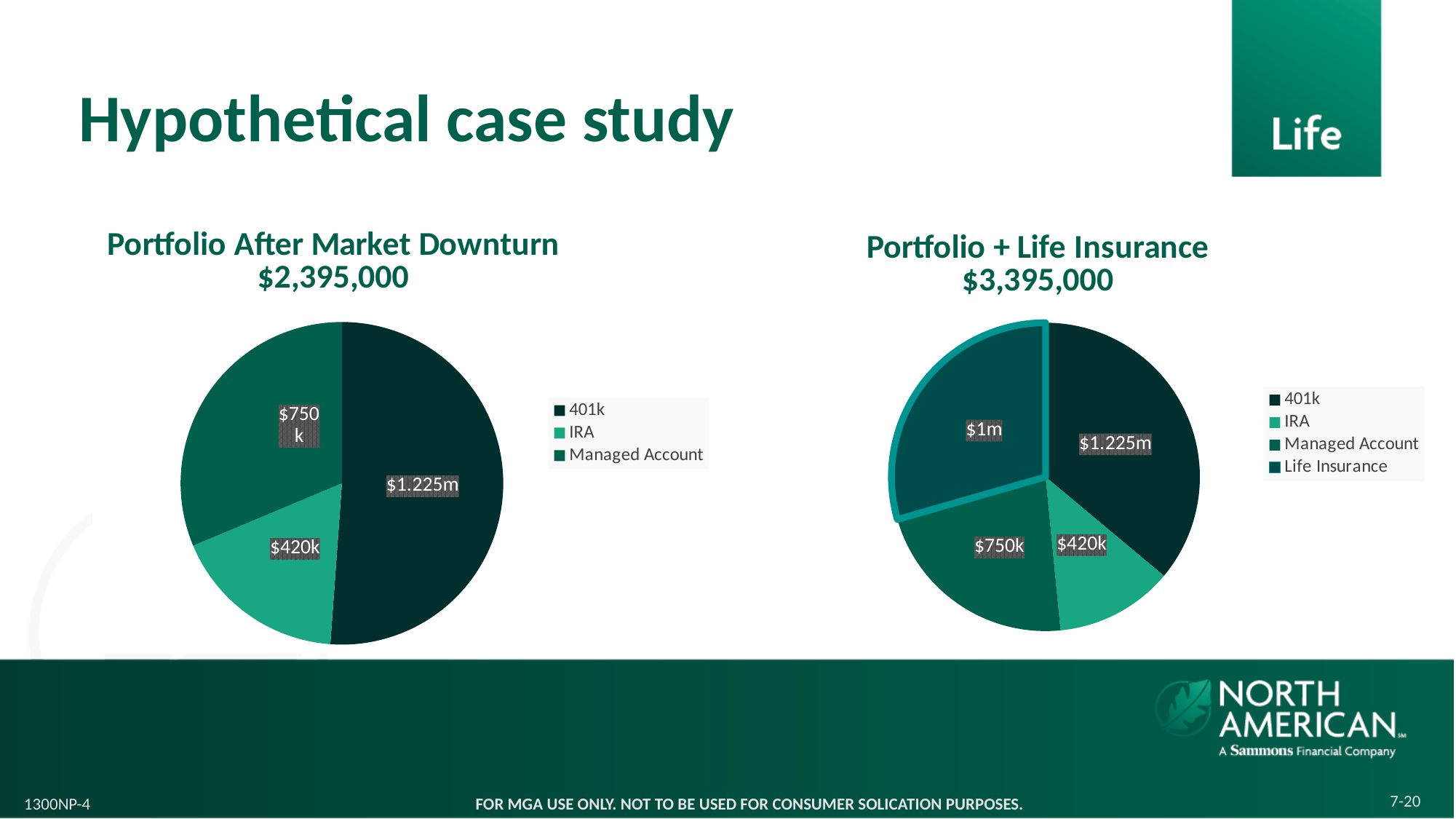
How many entries does the legend of the Portfolio After Market Downturn chart list? 3 In the Portfolio After Market Downturn chart, which category has the largest slice? 401k What total value is shown under the title of the Portfolio + Life Insurance chart? $3,395,000 What kind of chart is the Portfolio After Market Downturn chart? Pie chart In the Portfolio + Life Insurance chart, which is larger, the Life Insurance slice or the Managed Account slice? Life Insurance In the Portfolio After Market Downturn chart, what is the value of the 401k slice? $1.225m In the Portfolio After Market Downturn chart, what is the value of the IRA slice? $420k How many slices does the Portfolio + Life Insurance chart have? 4 In the Portfolio + Life Insurance chart, what is the value of the Managed Account slice? $750k In the Portfolio After Market Downturn chart, what is the difference between the 401k value and the IRA value? $805k In the Portfolio + Life Insurance chart, what is the value of the Life Insurance slice? $1m In the Portfolio + Life Insurance chart, which category has the smallest slice? IRA